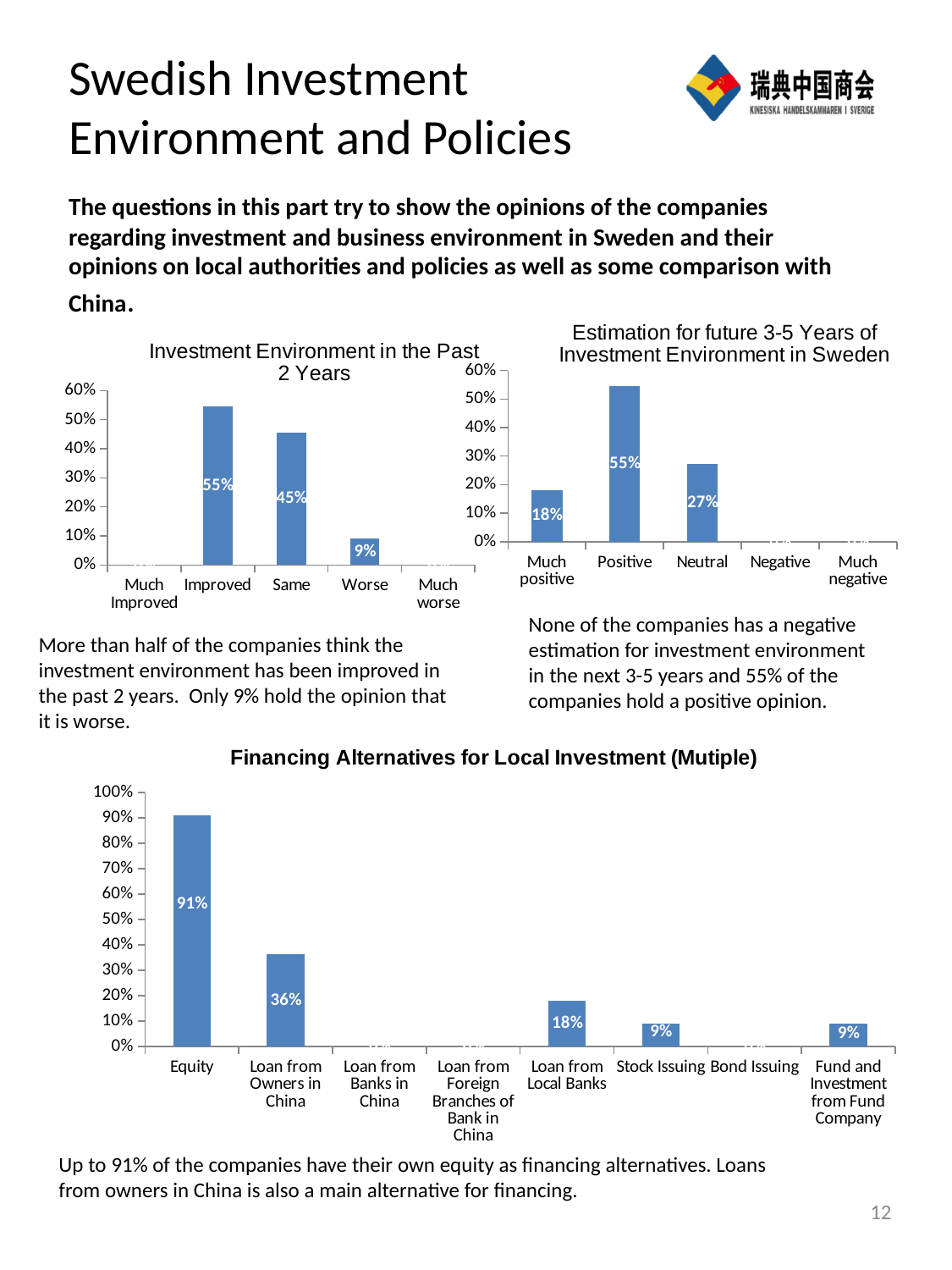
In the chart 'Financing Alternatives for Local Investment (Mutiple)', which category has the highest value? Equity In the chart 'Investment Environment in the Past 2 Years', what is the value for 'Worse'? 9% What type of chart is 'Financing Alternatives for Local Investment (Mutiple)'? Bar chart In the chart 'Investment Environment in the Past 2 Years', how many categories are shown on the x axis? 5 In the chart 'Investment Environment in the Past 2 Years', what is the difference between the 'Improved' and 'Same' values? 10% In the chart 'Financing Alternatives for Local Investment (Mutiple)', what is the difference between 'Equity' and 'Loan from Local Banks'? 73% In the chart 'Estimation for future 3-5 Years of Investment Environment in Sweden', which is larger, 'Much positive' or 'Neutral'? Neutral In the chart 'Estimation for future 3-5 Years of Investment Environment in Sweden', which category has the highest value? Positive In the chart 'Investment Environment in the Past 2 Years', what percentage of companies answered 'Improved'? 55% In the chart 'Estimation for future 3-5 Years of Investment Environment in Sweden', is the value for 'Much positive' greater or less than 20%? less In the chart 'Financing Alternatives for Local Investment (Mutiple)', what is the value for 'Loan from Owners in China'? 36% In the chart 'Estimation for future 3-5 Years of Investment Environment in Sweden', what is the value for 'Neutral'? 27%